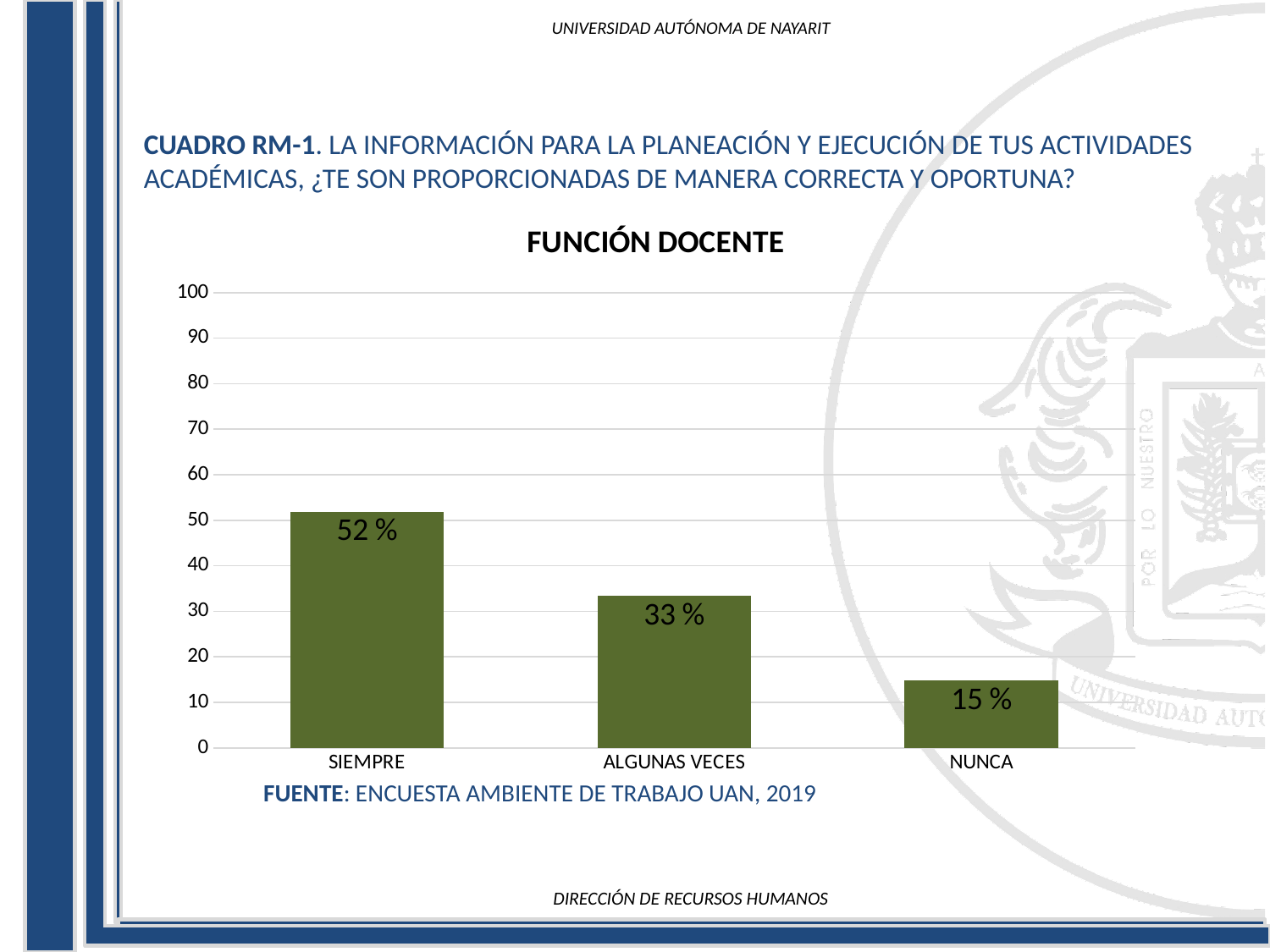
Which category has the lowest value? NUNCA How many categories are shown on the x axis? 3 What is the value for NUNCA? 15 % What is the value for ALGUNAS VECES? 33 % What is the title of the chart? FUNCIÓN DOCENTE What is the difference between the values for ALGUNAS VECES and NUNCA? 18 % Which category has the highest value? SIEMPRE Which is larger, the value for ALGUNAS VECES or the value for NUNCA? ALGUNAS VECES What is the value for SIEMPRE? 52 % What is the difference between the values for SIEMPRE and ALGUNAS VECES? 19 % Is the value for SIEMPRE greater or less than 50? greater What kind of chart is shown? bar chart